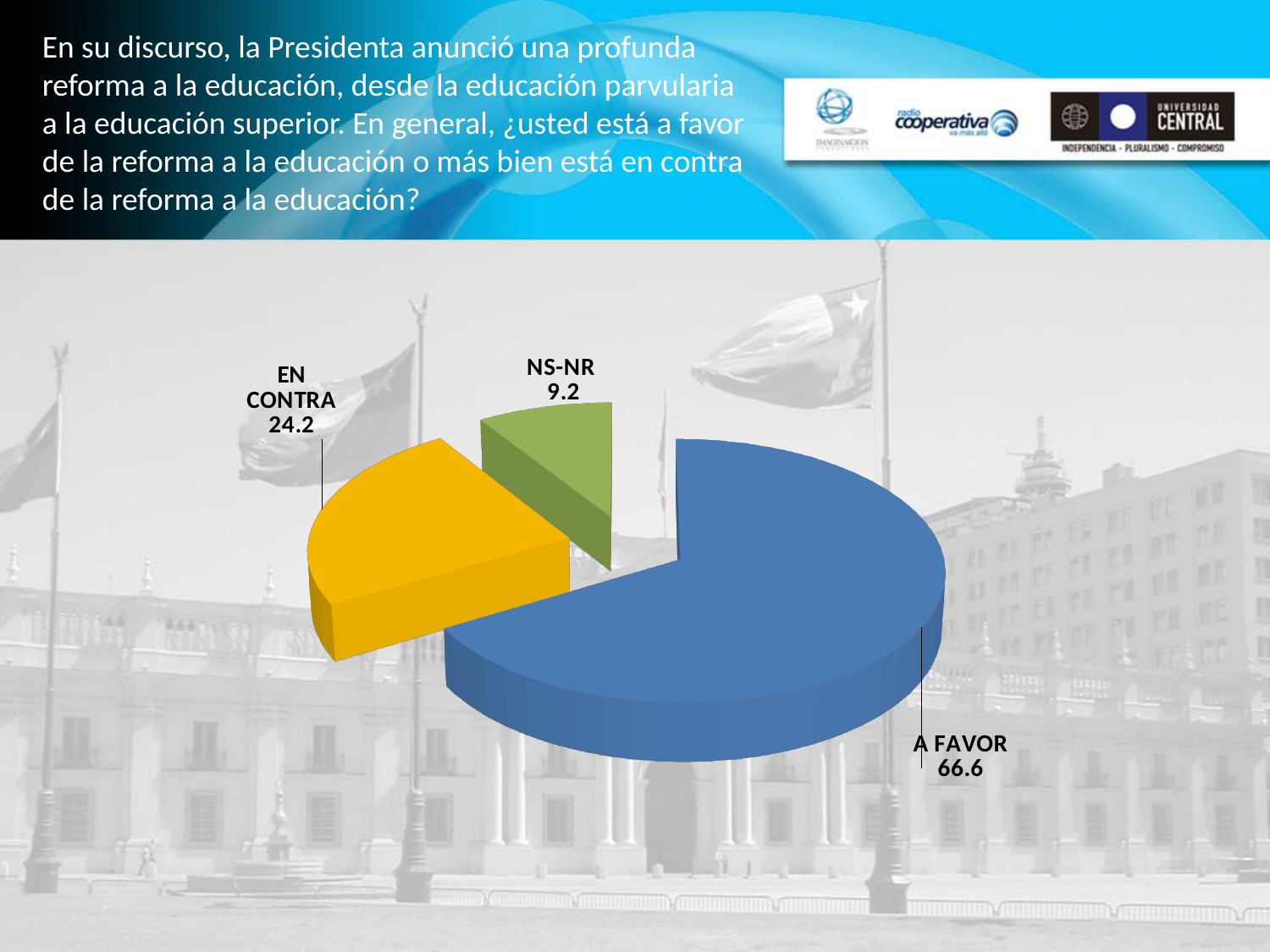
How many slices does the pie chart have? 3 Which category has the largest slice? A FAVOR What is the value for NS-NR? 9.2 What is the difference between the values for EN CONTRA and NS-NR? 15.0 What colour is the A FAVOR slice? Blue What is the difference between the values for A FAVOR and EN CONTRA? 42.4 Which category has the smallest slice? NS-NR What is the value for EN CONTRA? 24.2 What kind of chart is shown on the slide? Pie chart What is the value for A FAVOR? 66.6 Which is larger, EN CONTRA or NS-NR? EN CONTRA What colour is the EN CONTRA slice? Yellow